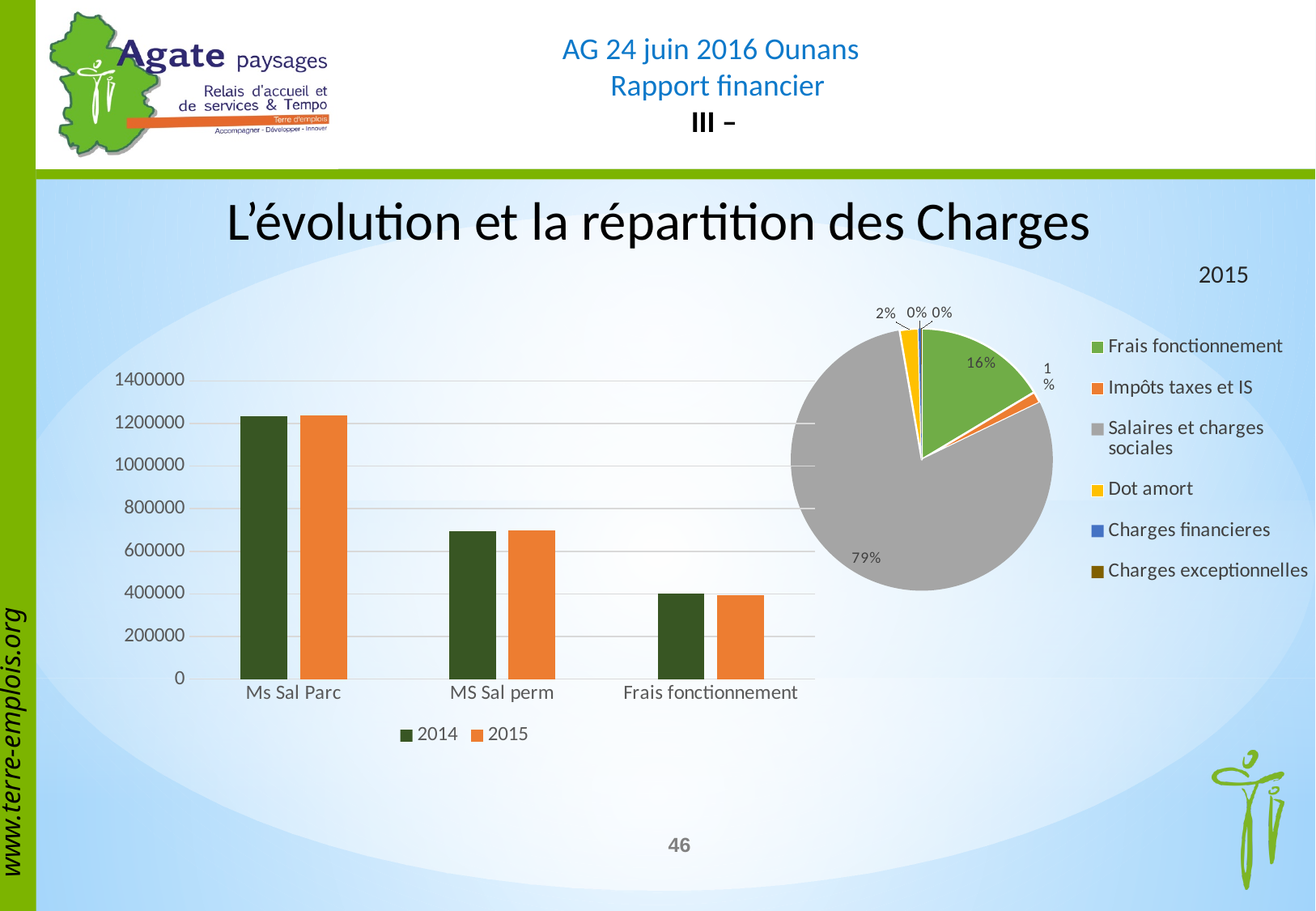
In the bar chart on the left, do the values rise or fall from left to right along the x axis? fall In the bar chart on the left, how many categories are shown on the x axis? 3 What kind of chart is the chart on the left of the slide? bar chart In the bar chart on the left, how many series does the legend list? 2 What kind of chart is the chart on the right of the slide, labelled 2015? pie chart In the pie chart labelled 2015, what is the difference between the shares of Salaires et charges sociales and Frais fonctionnement? 63% In the pie chart labelled 2015, what share does Frais fonctionnement have? 16% In the bar chart on the left, is the 2014 value for Ms Sal Parc greater or less than 1000000? greater In the pie chart labelled 2015, what share does Salaires et charges sociales have? 79% In the bar chart on the left, which category has the lowest bars? Frais fonctionnement In the bar chart on the left, which category has the highest bars? Ms Sal Parc In the bar chart on the left, is the 2015 value for MS Sal perm greater or less than 800000? less